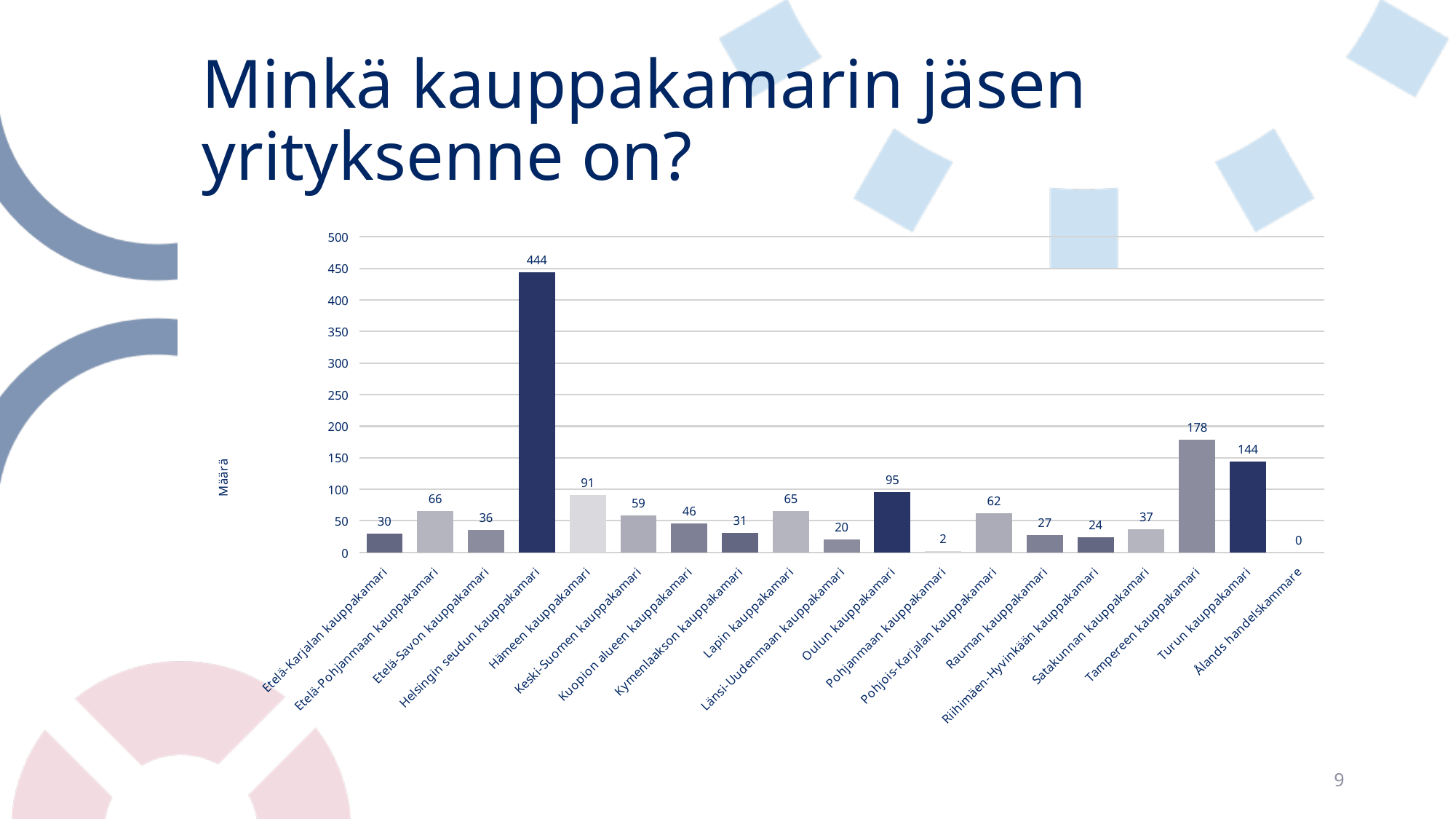
What kind of chart is shown on the slide? bar chart Which category has the lowest value? Ålands handelskammare What is the difference between the values for Tampereen kauppakamari and Turun kauppakamari? 34 How many categories are shown on the x axis? 19 What is the value for Pohjanmaan kauppakamari? 2 What is the value for Helsingin seudun kauppakamari? 444 Is the value for Helsingin seudun kauppakamari greater or less than 400? greater What is the value for Ålands handelskammare? 0 What is the label of the vertical axis? Määrä Which category has the highest value? Helsingin seudun kauppakamari Which is larger, the value for Hämeen kauppakamari or the value for Oulun kauppakamari? Oulun kauppakamari What is the value for Tampereen kauppakamari? 178